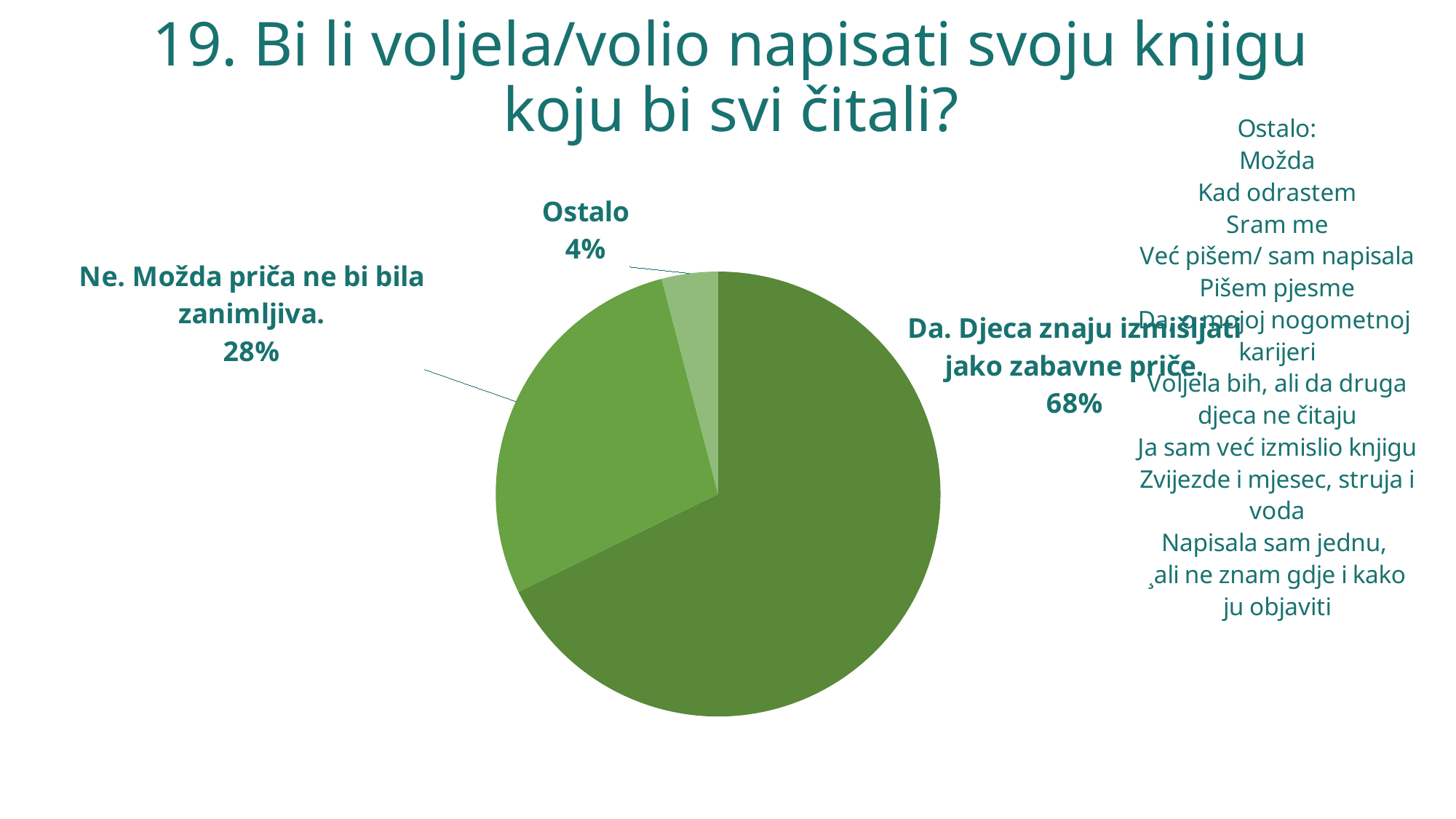
How many slices does the pie chart have? 3 Which is larger: the "Ne. Možda priča ne bi bila zanimljiva." slice or the "Ostalo" slice? Ne. Možda priča ne bi bila zanimljiva. What share of the pie does "Ostalo" have? 4% What is the combined share of the "Ne" and "Ostalo" slices? 32% Which slice of the pie is the largest? Da. Djeca znaju izmišljati jako zabavne priče. What share of the pie does "Ne. Možda priča ne bi bila zanimljiva." have? 28% What is the difference in percentage points between the "Ne" slice and the "Ostalo" slice? 24 percentage points What is the title of the chart on the slide? 19. Bi li voljela/volio napisati svoju knjigu koju bi svi čitali? What is the difference in percentage points between the "Da" slice and the "Ne" slice? 40 percentage points Which slice of the pie is the smallest? Ostalo What share of the pie does "Da. Djeca znaju izmišljati jako zabavne priče." have? 68% What kind of chart is shown on the slide? pie chart